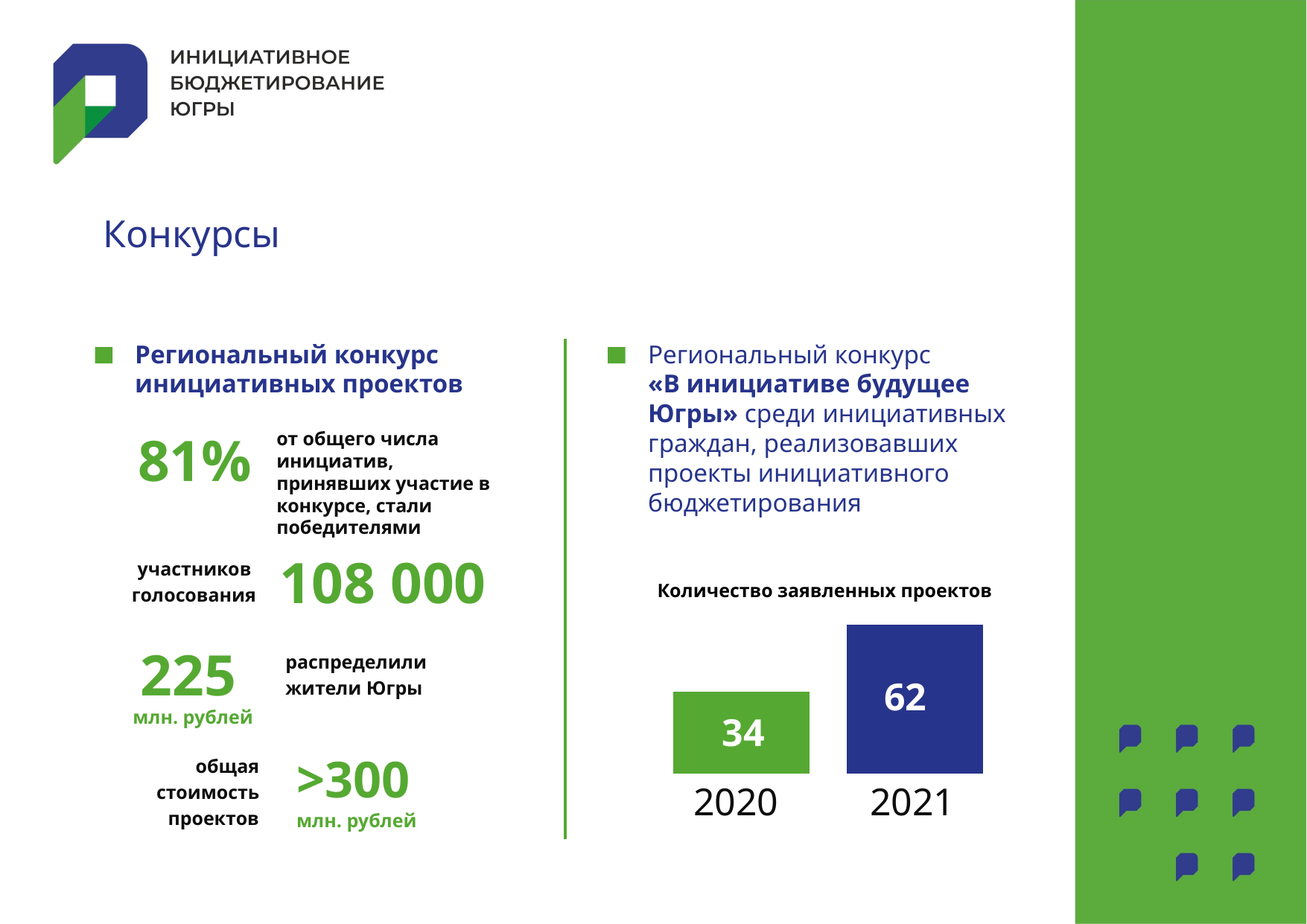
Which year has the highest value in the chart "Количество заявленных проектов"? 2021 What is the title of the chart on the right side of the slide? Количество заявленных проектов What is the value for 2021 in the chart "Количество заявленных проектов"? 62 What kind of chart is "Количество заявленных проектов"? bar chart In the chart "Количество заявленных проектов", which is larger: the value for 2020 or for 2021? 2021 How many categories (years) are shown in the chart "Количество заявленных проектов"? 2 What colour is the bar for 2021 in the chart "Количество заявленных проектов"? blue Which year has the lowest value in the chart "Количество заявленных проектов"? 2020 What is the difference between the 2021 and 2020 values in the chart "Количество заявленных проектов"? 28 Do the values in the chart "Количество заявленных проектов" rise or fall from 2020 to 2021? rise What is the value for 2020 in the chart "Количество заявленных проектов"? 34